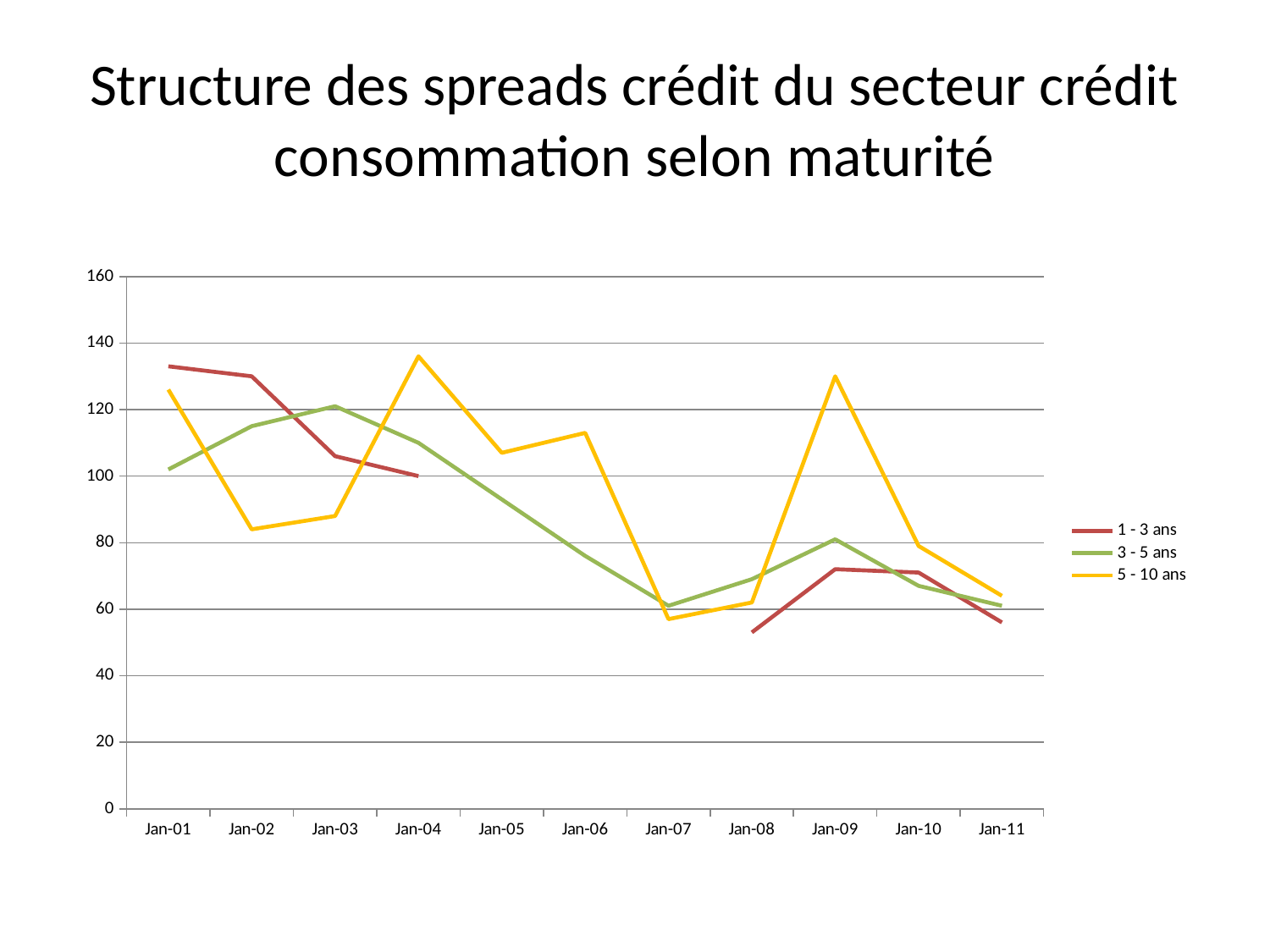
Which series is drawn in yellow? 5 - 10 ans Does the 3 - 5 ans series rise or fall from Jan-03 to Jan-07? fall Is the value for 5 - 10 ans at Jan-06 greater or less than 100? greater At Jan-09, which series has the higher value, 5 - 10 ans or 3 - 5 ans? 5 - 10 ans At Jan-02, which series has the higher value, 1 - 3 ans or 5 - 10 ans? 1 - 3 ans Is the value for 1 - 3 ans at Jan-08 greater or less than 60? less How many series does the legend list? 3 Is the value for 3 - 5 ans at Jan-05 greater or less than 100? less How many dates are shown on the x axis? 11 What kind of chart is shown on the slide? line chart What is the title of the chart? Structure des spreads crédit du secteur crédit consommation selon maturité